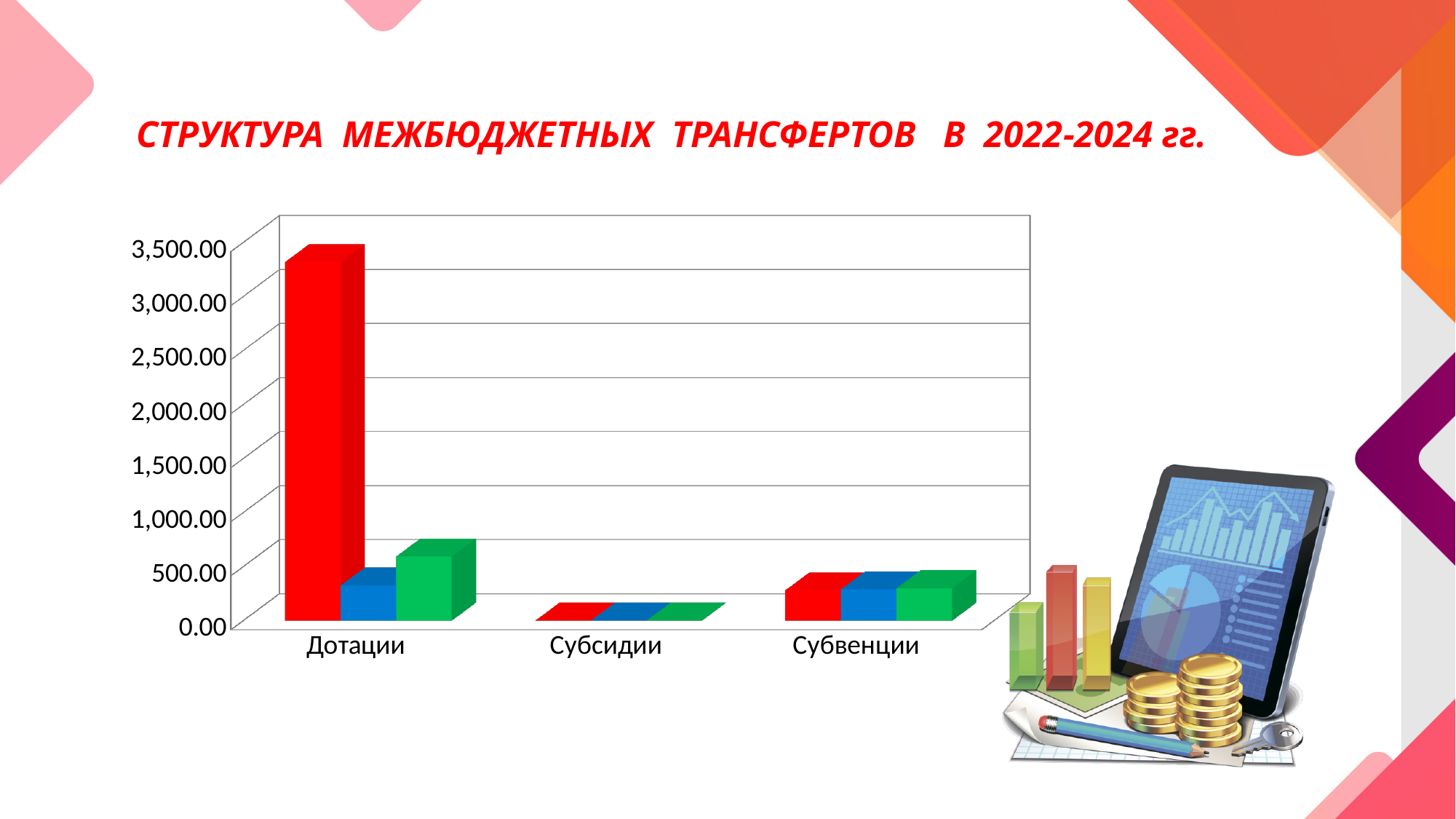
Which category has the lowest bars in the chart? Субсидии How many categories are shown on the x axis of the chart? 3 What is the highest value shown on the vertical axis of the chart? 3,500.00 What kind of chart is shown on the slide? bar chart Which category has the tallest bar in the chart? Дотации Which is larger: the blue bar for Дотации or the green bar for Дотации? the green bar for Дотации Which is larger: the red bar for Дотации or the red bar for Субвенции? the red bar for Дотации What is the title of the slide? СТРУКТУРА МЕЖБЮДЖЕТНЫХ ТРАНСФЕРТОВ В 2022-2024 гг. Is the value of the red bar for Дотации greater or less than 3,000.00? greater Is the value of the green bar for Субсидии greater or less than 500.00? less Is the value of the blue bar for Дотации greater or less than 500.00? less